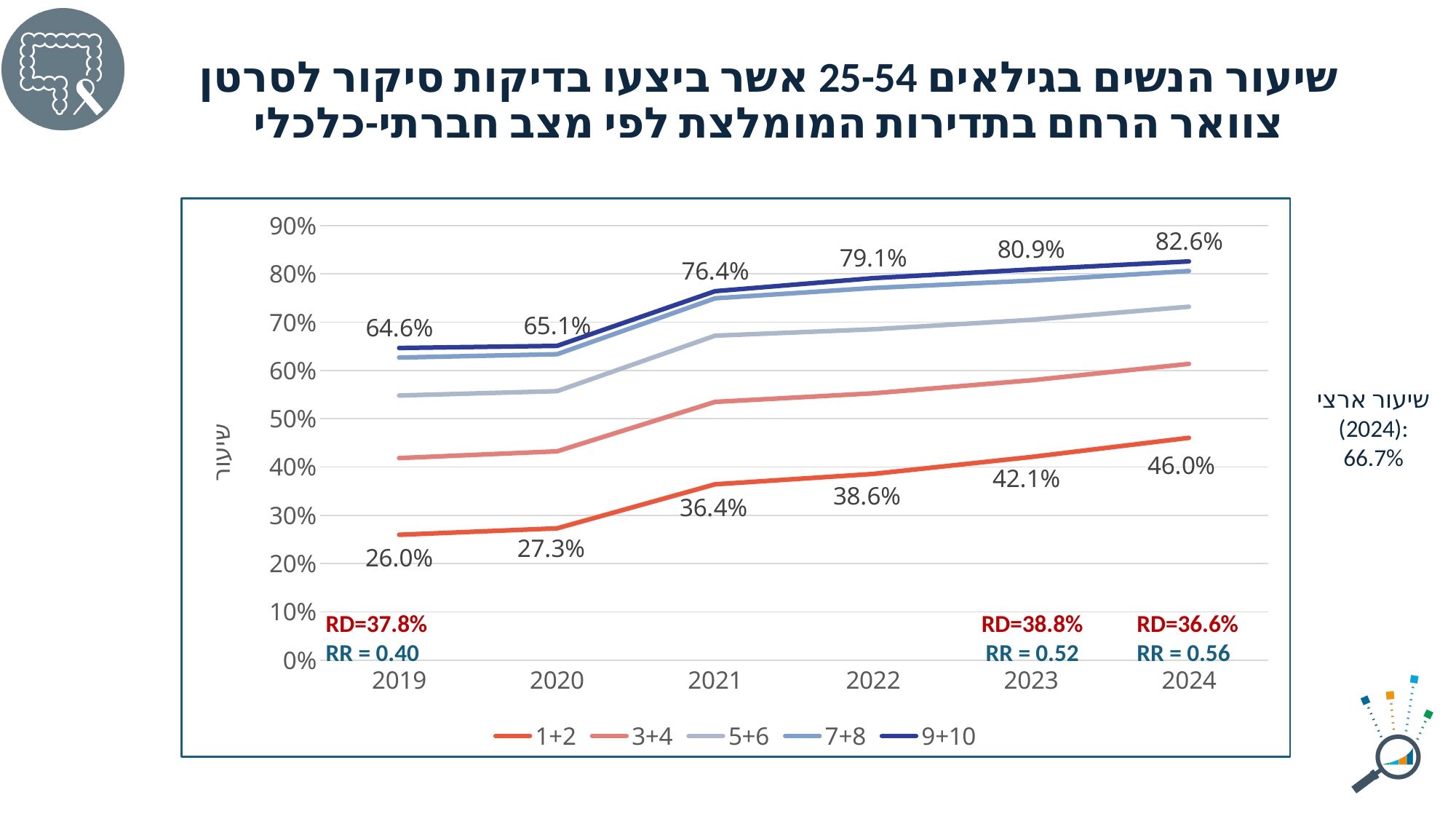
What is the value for the 9+10 series in 2024? 82.6% Does the 1+2 series rise or fall from 2019 to 2024? rise In which year is the 1+2 series at its lowest? 2019 How many series does the legend list? 5 What kind of chart is shown on the slide? line chart What is the value for the 1+2 series in 2022? 38.6% In which year is the 9+10 series at its highest? 2024 Which series has the larger value in 2020, 9+10 or 1+2? 9+10 What is the difference between the 9+10 and 1+2 series in 2021? 40.0% How many years are shown on the x axis? 6 Is the value for the 5+6 series in 2024 greater or less than 70%? greater What is the value for the 1+2 series in 2019? 26.0%